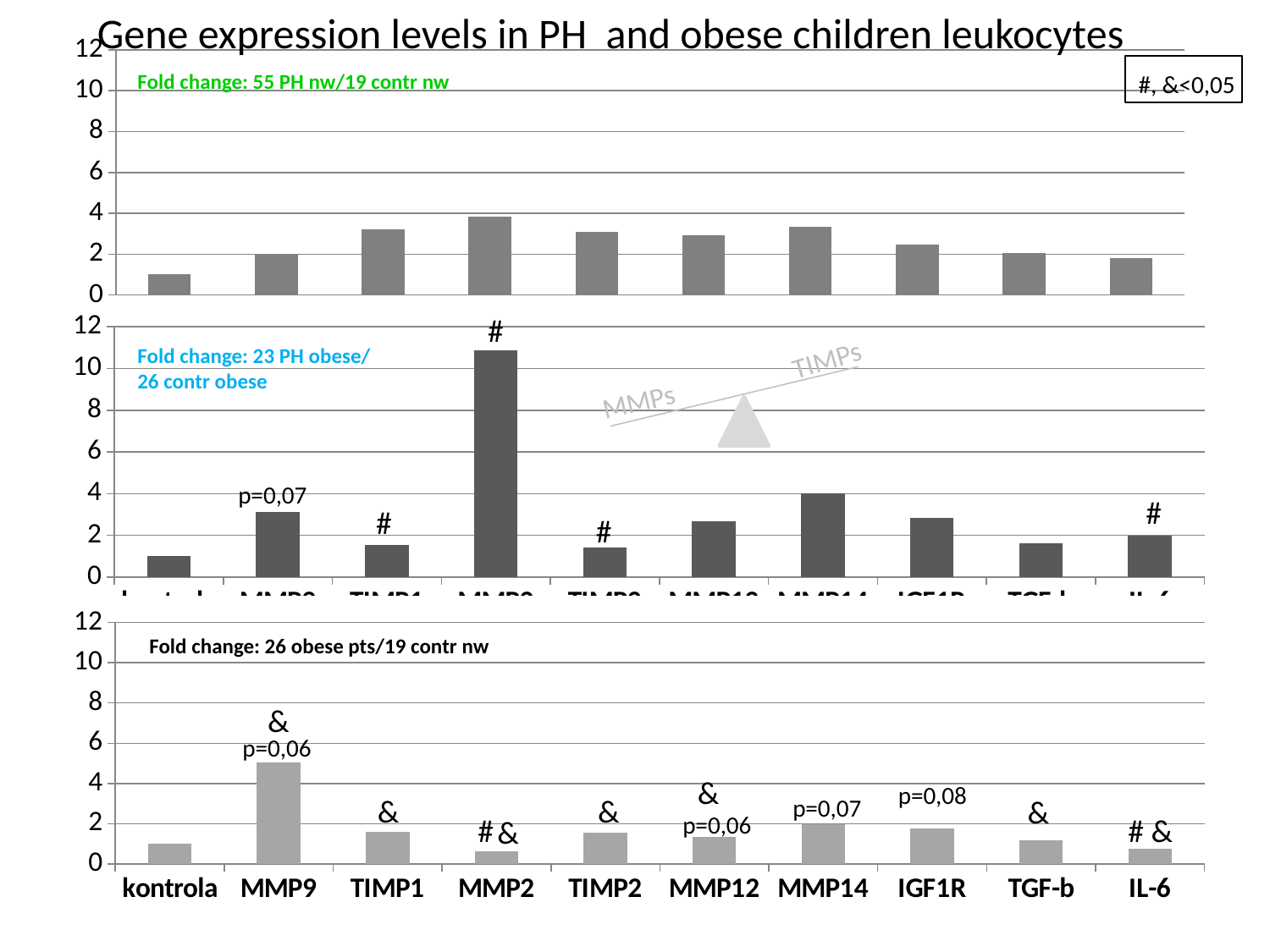
In the bottom chart (Fold change: 26 obese pts/19 contr nw), is the value for MMP9 greater or less than 4? greater In the bottom chart (Fold change: 26 obese pts/19 contr nw), is the value for MMP2 greater or less than 2? less In the bottom chart (Fold change: 26 obese pts/19 contr nw), which is larger, the value for MMP9 or the value for TIMP2? MMP9 In the middle chart (Fold change: 23 PH obese/26 contr obese), is the tallest bar greater or less than 10? greater How many categories are shown on the x axis of the bottom chart (Fold change: 26 obese pts/19 contr nw)? 10 What kind of chart is used in each of the three panels on the slide? bar chart In the bottom chart (Fold change: 26 obese pts/19 contr nw), what p-value is printed above the IGF1R bar? p=0,08 In the bottom chart (Fold change: 26 obese pts/19 contr nw), what p-value is printed above the MMP9 bar? p=0,06 How many bar charts are shown on the slide? 3 In the bottom chart (Fold change: 26 obese pts/19 contr nw), which category has the highest bar? MMP9